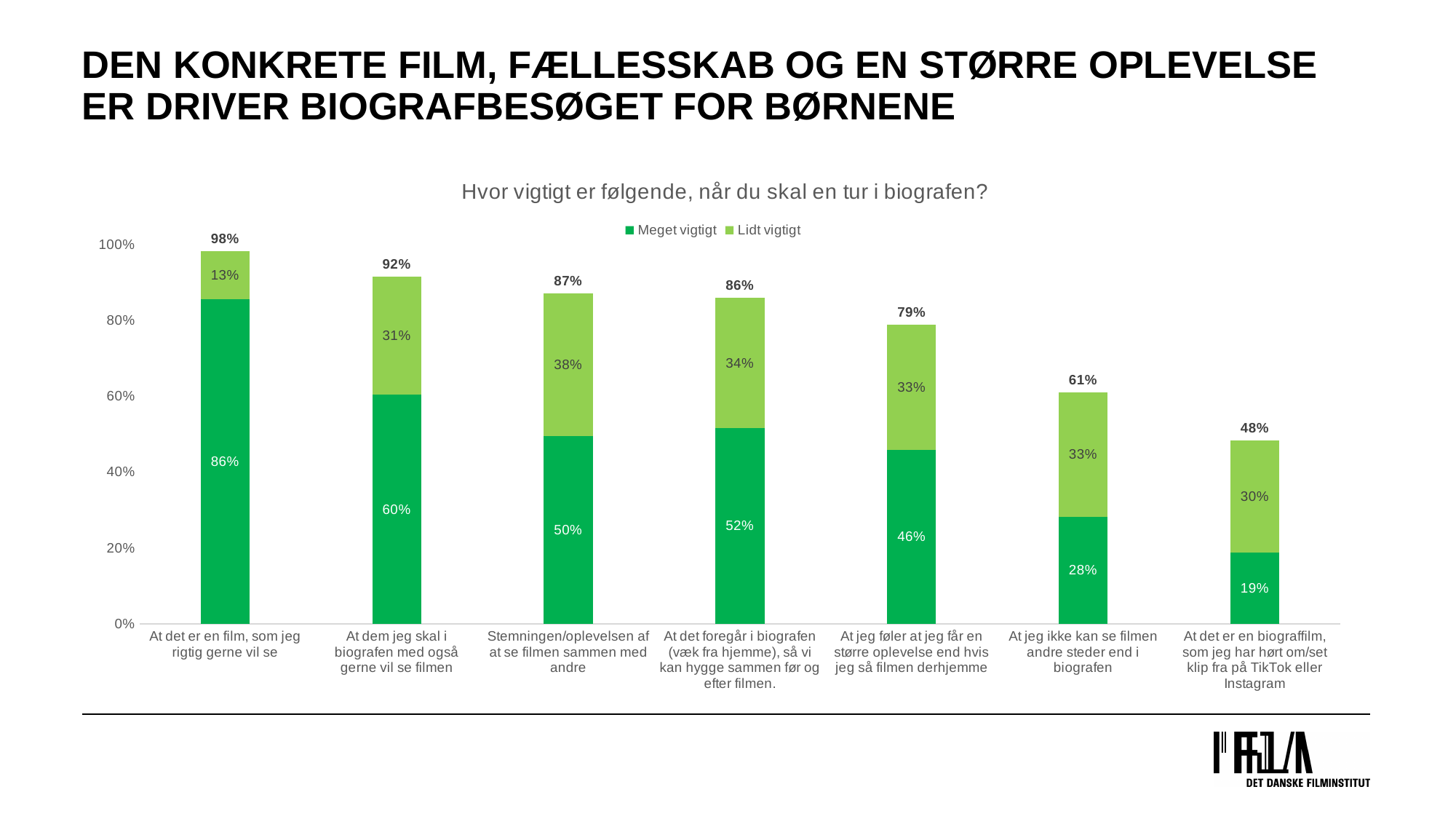
Which category has the lowest total? At det er en biograffilm, som jeg har hørt om/set klip fra på TikTok eller Instagram Which is larger: the 'Lidt vigtigt' value for 'Stemningen/oplevelsen af at se filmen sammen med andre' or for 'At jeg føler at jeg får en større oplevelse end hvis jeg så filmen derhjemme'? Stemningen/oplevelsen af at se filmen sammen med andre What is the total printed above the bar for 'At jeg ikke kan se filmen andre steder end i biografen'? 61% What kind of chart is shown on the slide? Stacked bar chart How many series does the legend list? 2 What is the title of the chart? Hvor vigtigt er følgende, når du skal en tur i biografen? What is the difference between the 'Meget vigtigt' values for 'At det foregår i biografen (væk fra hjemme), så vi kan hygge sammen før og efter filmen.' and 'Stemningen/oplevelsen af at se filmen sammen med andre'? 2% What is the 'Lidt vigtigt' value for 'At dem jeg skal i biografen med også gerne vil se filmen'? 31% What is the 'Meget vigtigt' value for 'At det er en film, som jeg rigtig gerne vil se'? 86% How many categories are shown on the x axis? 7 Do the total values rise or fall from left to right along the x axis? Fall Which category has the highest 'Meget vigtigt' value? At det er en film, som jeg rigtig gerne vil se